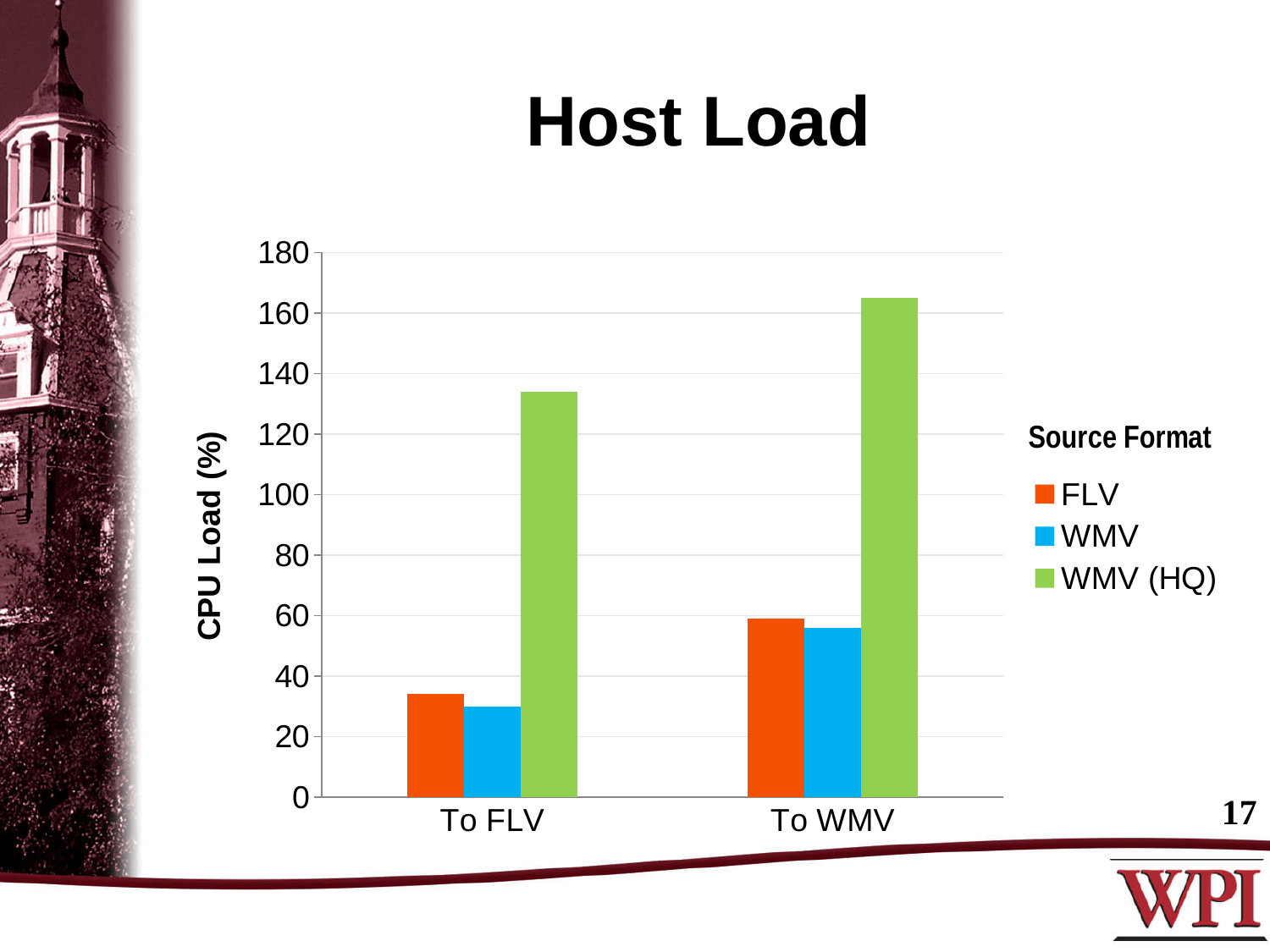
Is the value for WMV (HQ) in the To WMV category greater or less than 140? greater What is the label of the y axis? CPU Load (%) Which series has the highest CPU load in the To WMV category? WMV (HQ) Is the value for WMV (HQ) in the To FLV category greater or less than 120? greater How many series does the legend list? 3 Is the value for FLV in the To FLV category greater or less than 40? less What kind of chart is shown on the slide? bar chart Which series has the lowest CPU load in the To FLV category? WMV Does the CPU load for the FLV source format rise or fall from To FLV to To WMV? rise How many categories are shown on the x axis? 2 What is the title of the chart? Host Load Is the value for WMV (HQ) larger in the To FLV category or the To WMV category? To WMV